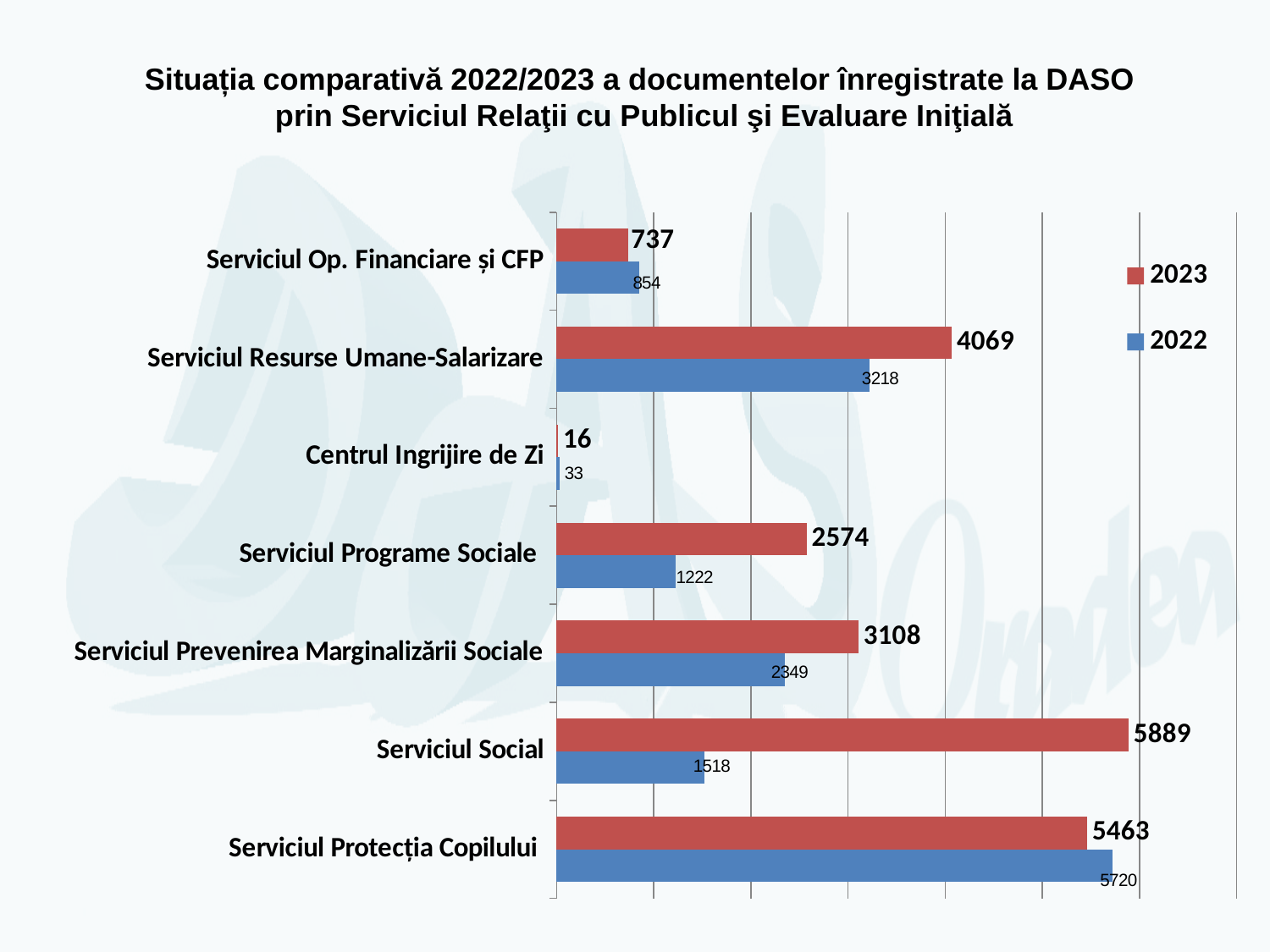
What is the difference between the 2023 and 2022 values for Serviciul Resurse Umane-Salarizare? 851 Which category has the lowest 2022 value? Centrul Ingrijire de Zi What is the difference between the 2023 and 2022 values for Serviciul Social? 4371 What is the 2023 value for Serviciul Social? 5889 Which colour represents the 2023 series in the legend? red What kind of chart is shown on the slide? bar chart Which category has the highest 2023 value? Serviciul Social For Serviciul Op. Financiare și CFP, which is larger: the 2023 value or the 2022 value? 2022 How many categories are shown on the chart? 7 How many series does the legend list? 2 What is the 2022 value for Serviciul Protecția Copilului? 5720 What is the 2022 value for Serviciul Programe Sociale? 1222